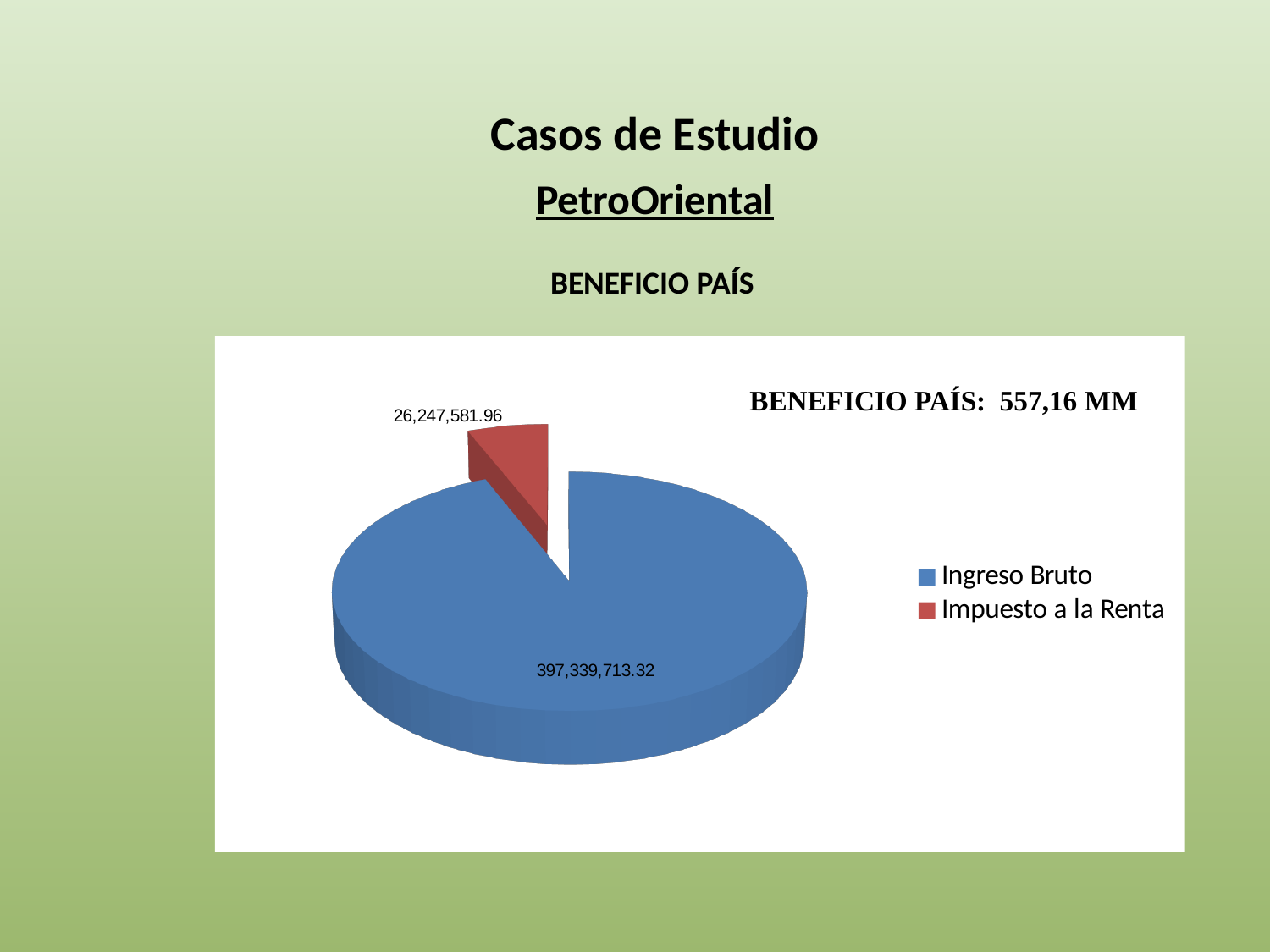
What is the value of the Ingreso Bruto slice in the pie chart? 397,339,713.32 How many entries does the chart legend list? 2 What kind of chart is shown on the slide? Pie chart What is the difference between the Ingreso Bruto value and the Impuesto a la Renta value? 371,092,131.36 Which category has the smallest slice in the pie chart? Impuesto a la Renta How many slices does the pie chart have? 2 Which category has the largest slice in the pie chart? Ingreso Bruto Which is larger, Ingreso Bruto or Impuesto a la Renta? Ingreso Bruto What colour is the Impuesto a la Renta slice? Red What BENEFICIO PAÍS figure is printed inside the chart area? 557,16 MM What is the value of the Impuesto a la Renta slice in the pie chart? 26,247,581.96 What is the sum of the two values shown in the pie chart? 423,587,295.28